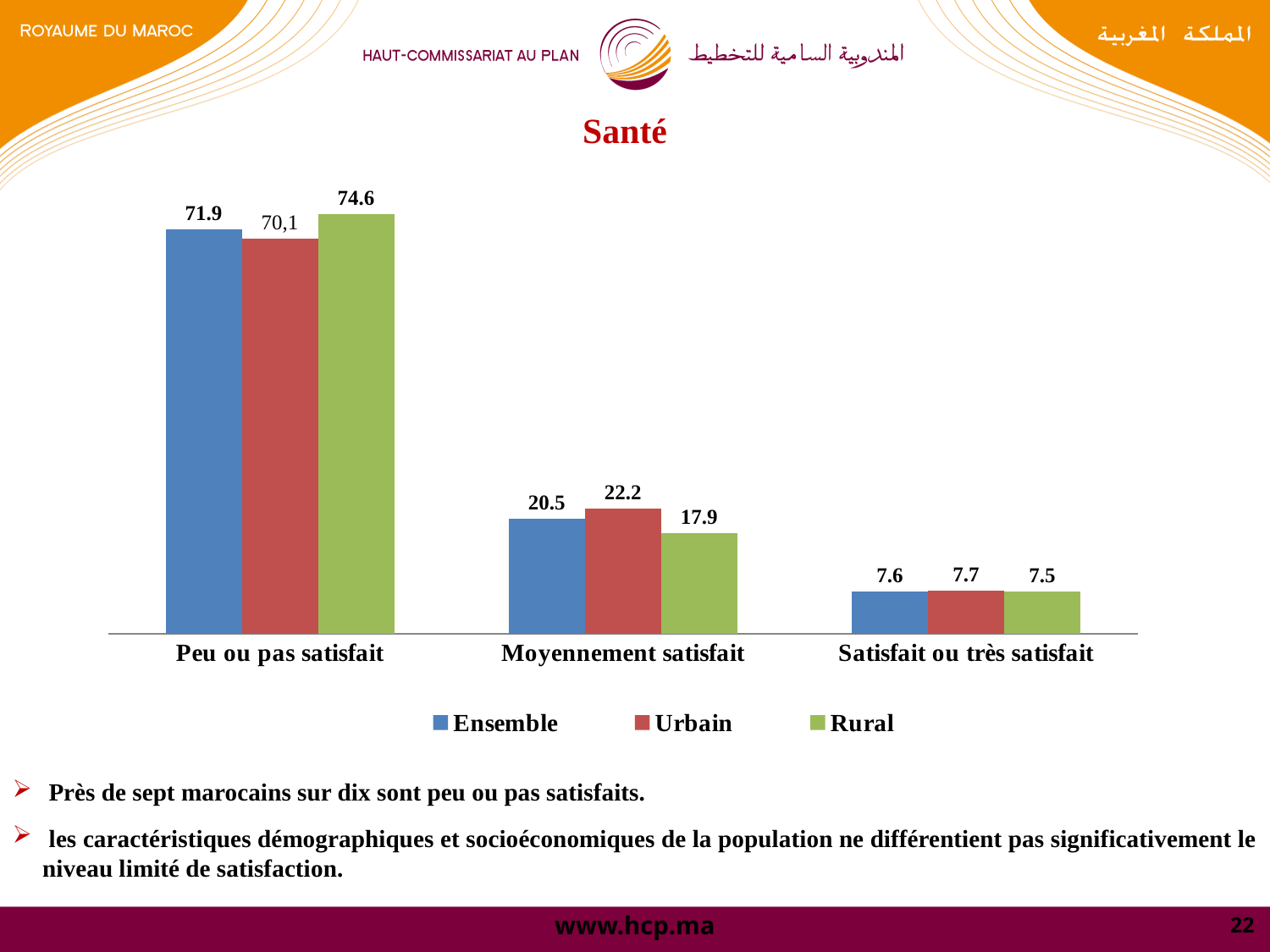
How many series does the legend list? 3 Which series has the highest value in the 'Peu ou pas satisfait' category? Rural Which series has the lowest value in the 'Moyennement satisfait' category? Rural What kind of chart is shown on the slide? Bar chart Which is larger in the 'Moyennement satisfait' category: Ensemble or Urbain? Urbain Do the Ensemble values rise or fall from 'Peu ou pas satisfait' to 'Satisfait ou très satisfait'? Fall What is the title of the chart? Santé What is the value for Ensemble in the 'Peu ou pas satisfait' category? 71.9 How many categories are shown on the x axis? 3 What is the value for Urbain in the 'Satisfait ou très satisfait' category? 7.7 What is the value for Rural in the 'Moyennement satisfait' category? 17.9 What is the difference between the Rural and Urbain values in the 'Moyennement satisfait' category? 4.3